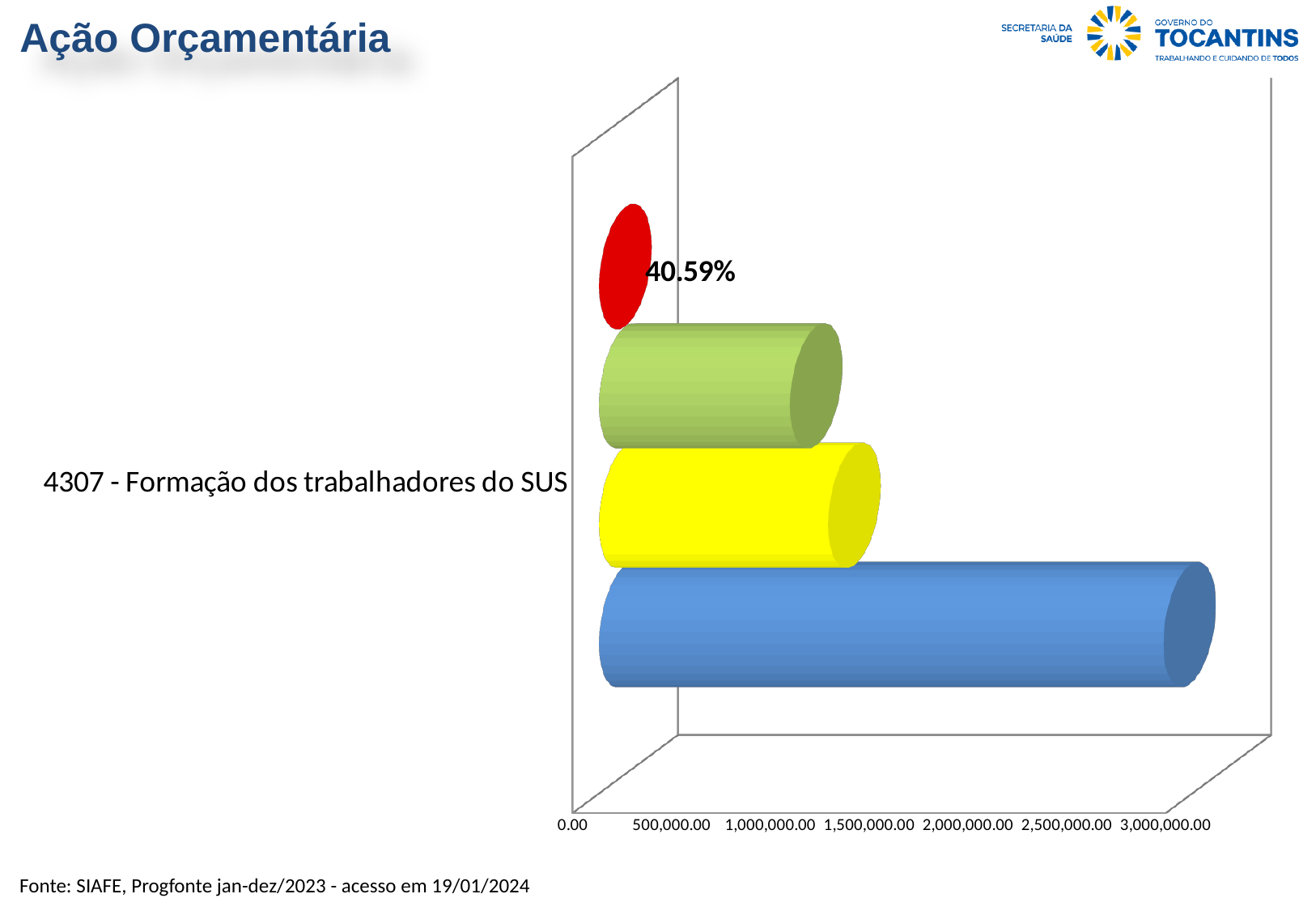
Which bar is longer, the blue bar or the yellow bar? blue How many categories are shown on the chart's vertical axis? 1 Which coloured bar is the shortest on the chart? red Is the value of the yellow bar greater or less than 1,000,000.00? greater Is the value of the green bar greater or less than 500,000.00? greater What is the category label shown on the chart? 4307 - Formação dos trabalhadores do SUS What kind of chart is shown on the slide? bar chart What percentage value is printed as a data label on the red bar? 40.59% Is the value of the blue bar greater or less than 2,000,000.00? greater Which coloured bar is the longest on the chart? blue What is the highest tick value shown on the horizontal axis? 3,000,000.00